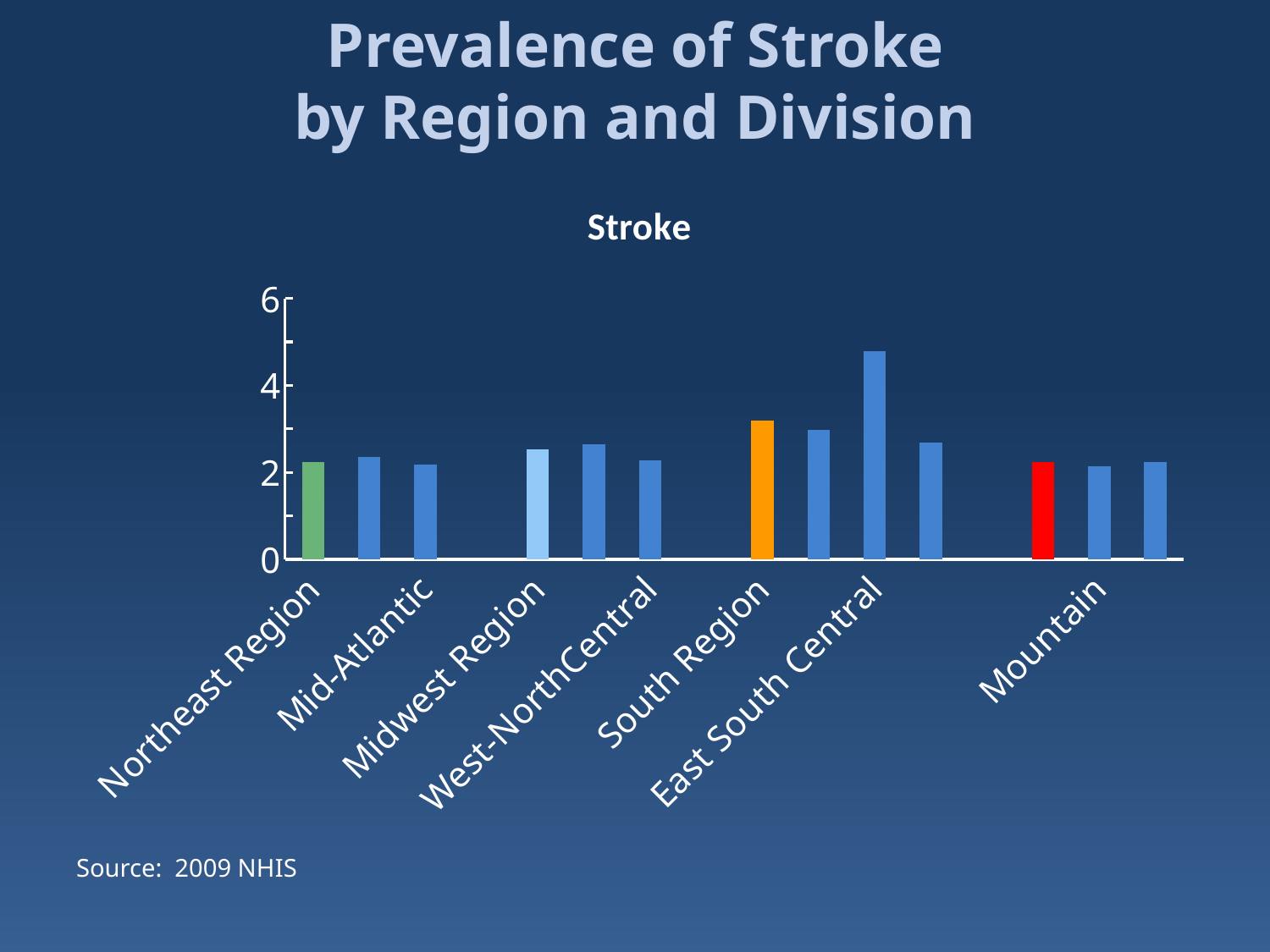
Which labeled division has the highest stroke prevalence? East South Central Is the value for East South Central greater or less than 4? greater Which is larger, the value for East South Central or the value for South Region? East South Central Which is larger, the value for East South Central or the value for Mountain? East South Central What is the highest value shown on the vertical axis? 6 Is the value for South Region greater or less than 2? greater What is the title shown above the chart? Stroke Is the value for South Region greater or less than 4? less Which is larger, the value for South Region or the value for Northeast Region? South Region What kind of chart is shown on the slide? bar chart What colour is the bar for Mountain? blue